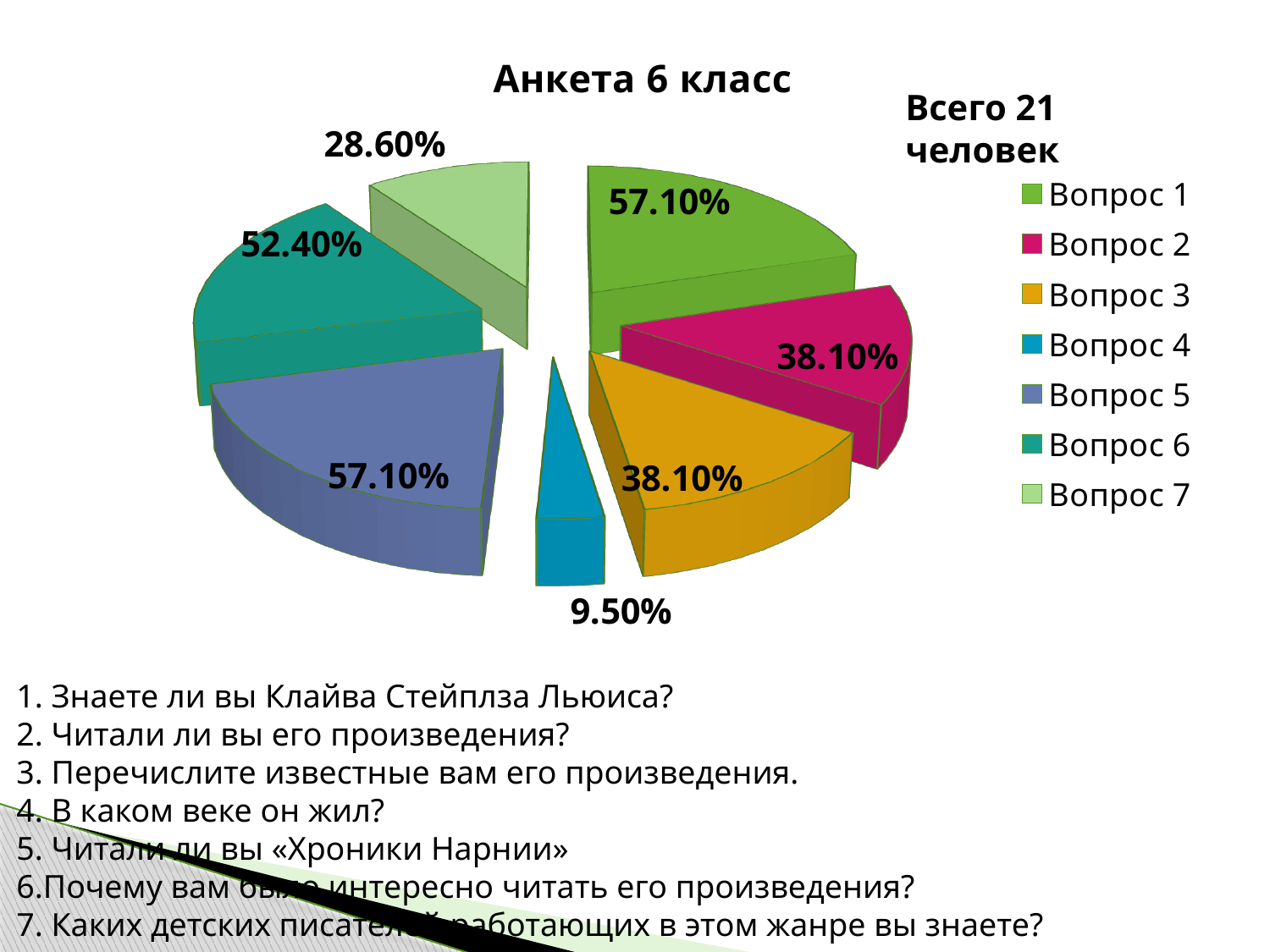
What is the title of the chart? Анкета 6 класс What value is shown for Вопрос 2 on the pie chart? 38.10% What is the difference between the values for Вопрос 5 and Вопрос 4? 47.60% What value is shown for Вопрос 1 on the pie chart? 57.10% What value is shown for Вопрос 4 on the pie chart? 9.50% What value is shown for Вопрос 6 on the pie chart? 52.40% Which category has the lowest value on the pie chart? Вопрос 4 What is the difference between the values for Вопрос 6 and Вопрос 7? 23.80% What kind of chart is shown on the slide? Pie chart How many slices does the pie chart have? 7 Which has a larger value, Вопрос 6 or Вопрос 7? Вопрос 6 What value is shown for Вопрос 7 on the pie chart? 28.60%